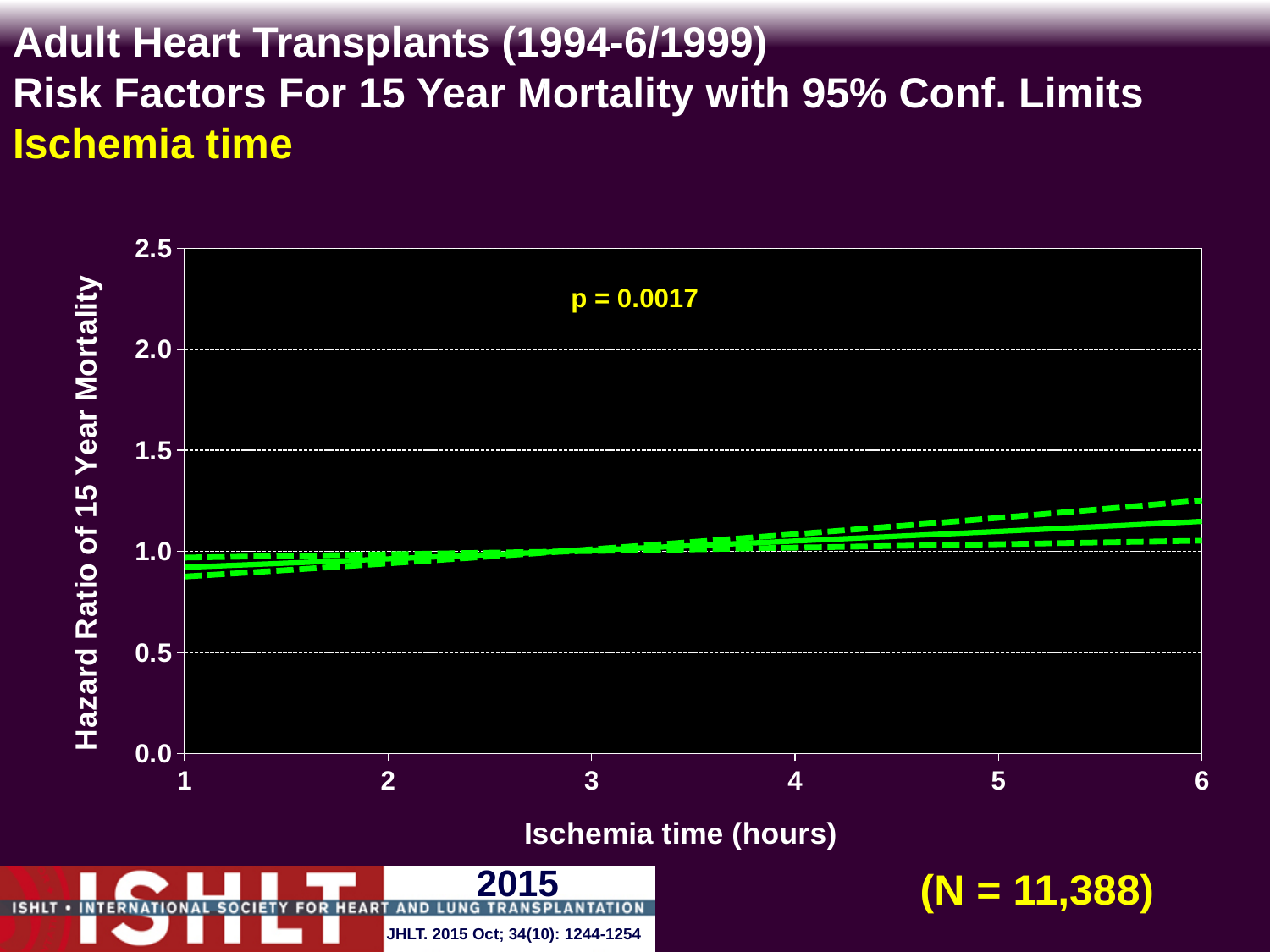
What is the highest value shown on the y axis? 2.5 What is the p value printed on the chart? p = 0.0017 Is the hazard ratio at an ischemia time of 1 hour greater or less than 1.0? less What is the sample size (N) shown on the slide? N = 11,388 Is the hazard ratio at an ischemia time of 6 hours greater or less than 1.0? greater What kind of chart is shown on the slide? Line chart What is the label of the x axis? Ischemia time (hours) Is the hazard ratio at an ischemia time of 6 hours greater or less than 1.5? less Does the hazard ratio rise or fall as ischemia time increases from 1 to 6 hours? Rise Which has the higher hazard ratio, an ischemia time of 1 hour or 6 hours? 6 hours What is the label of the y axis? Hazard Ratio of 15 Year Mortality